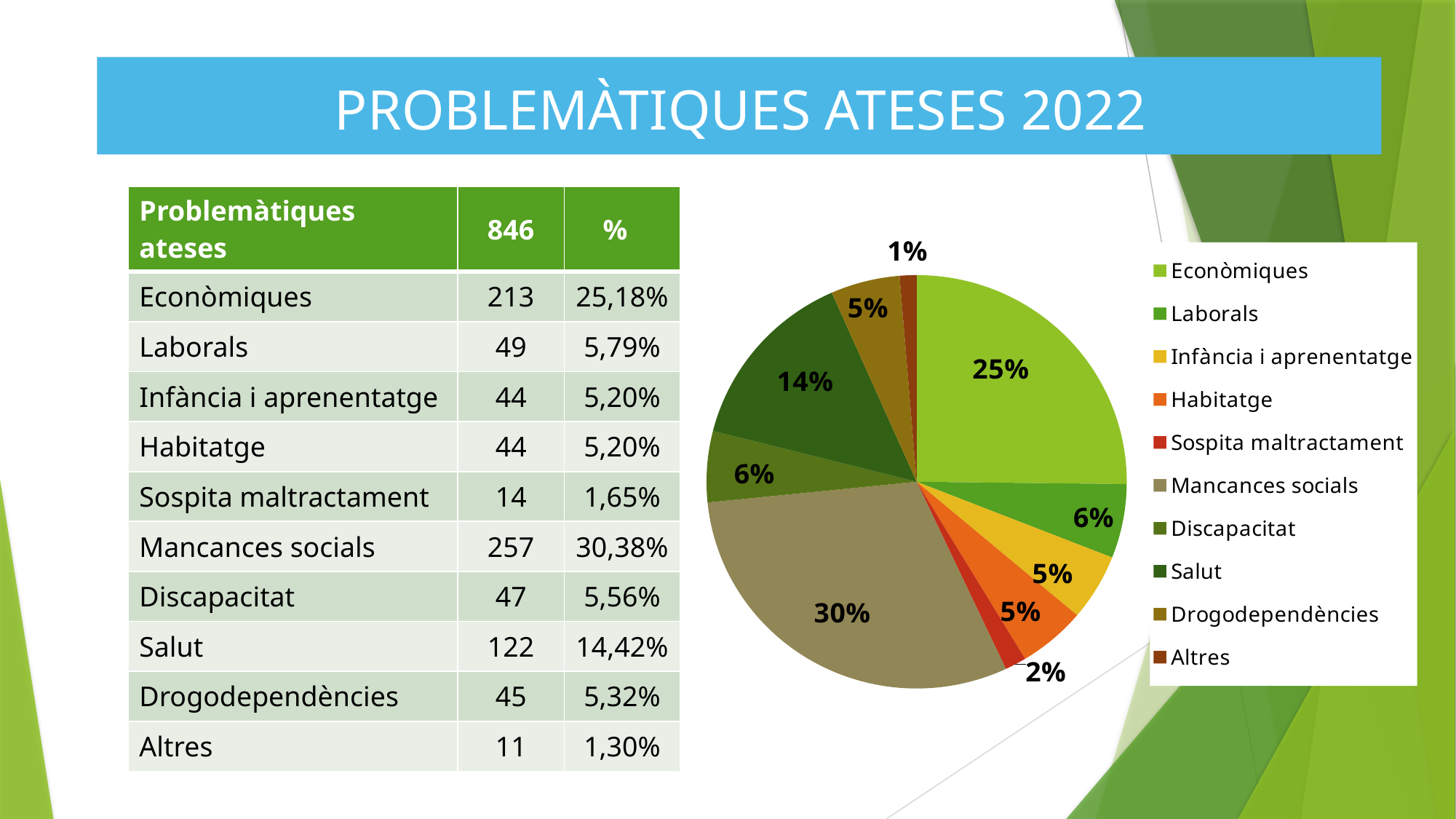
What share of the pie chart does Sospita maltractament represent? 2% Which category has the largest slice in the pie chart? Mancances socials What share of the pie chart does Altres represent? 1% How many categories does the pie chart legend list? 10 What share of the pie chart does Mancances socials represent? 30% Which category has the smallest slice in the pie chart? Altres What is the title of the slide containing the pie chart? PROBLEMÀTIQUES ATESES 2022 What kind of chart is shown on the slide? pie chart In the pie chart, which is larger: Salut or Econòmiques? Econòmiques What is the difference in percentage points between the Mancances socials slice and the Salut slice in the pie chart? 16%